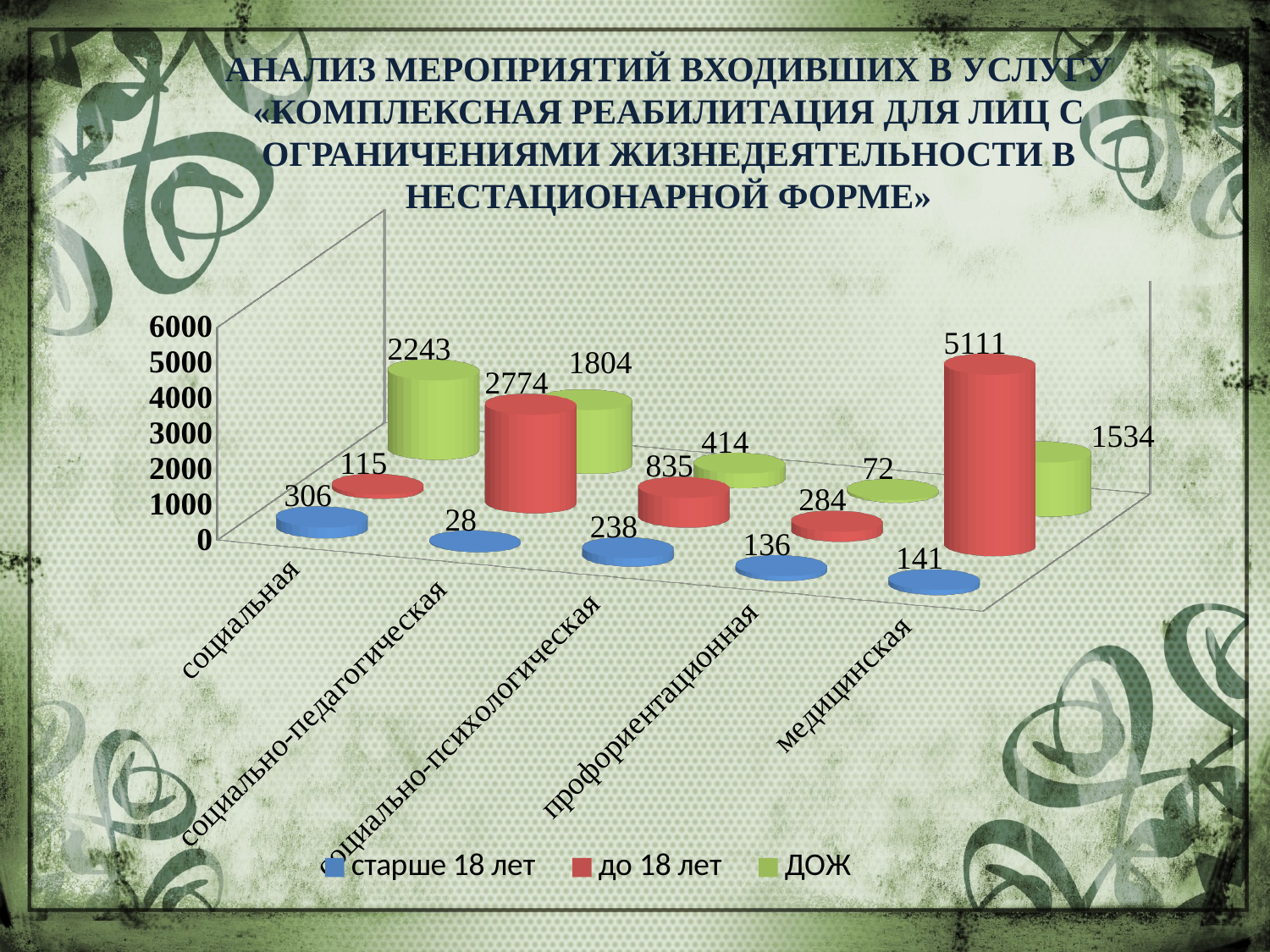
What is the value for «социально-педагогическая» in the «старше 18 лет» series? 28 How many categories are shown on the x axis? 5 Which category has the highest value in the «до 18 лет» series? медицинская What is the value for «медицинская» in the «до 18 лет» series? 5111 Which colour represents the «ДОЖ» series? green What is the value for «социальная» in the «ДОЖ» series? 2243 What is the value for «профориентационная» in the «ДОЖ» series? 72 What is the difference between the «до 18 лет» and «ДОЖ» values for «медицинская»? 3577 How many series does the legend list? 3 Which is larger for «социально-психологическая»: the «до 18 лет» value or the «ДОЖ» value? до 18 лет What kind of chart is shown on the slide? bar chart Which category has the lowest value in the «старше 18 лет» series? социально-педагогическая